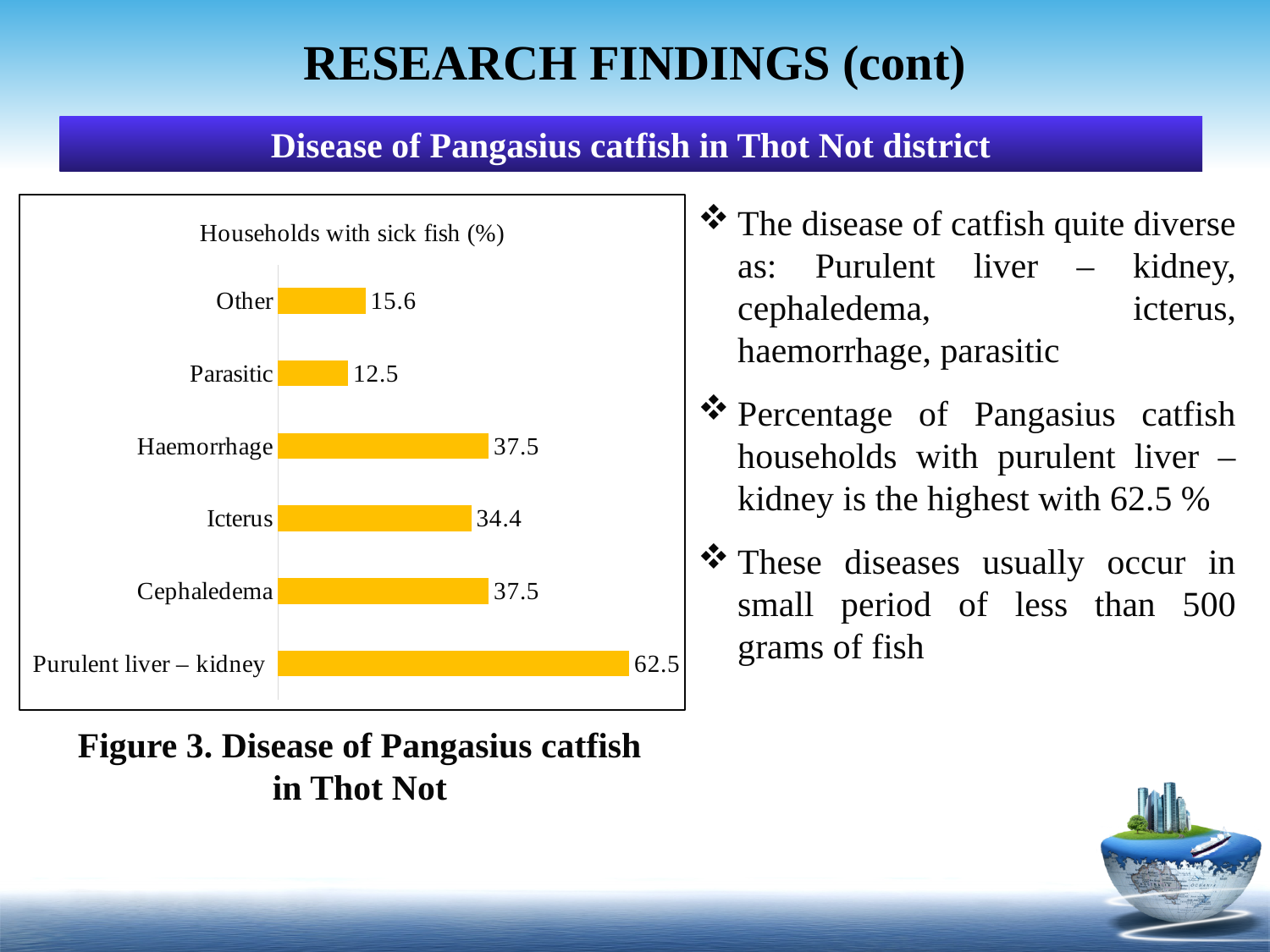
What is the difference between the values for Other and Parasitic? 3.1 What is the difference between the values for Purulent liver – kidney and Haemorrhage? 25 How many disease categories are shown in the chart? 6 What kind of chart is shown on the slide? Bar chart What is the value for Other in the chart? 15.6 Which disease category has the lowest percentage of households with sick fish? Parasitic What is the value for Purulent liver – kidney in the chart? 62.5 What is the value for Parasitic in the chart? 12.5 Which disease category has the highest percentage of households with sick fish? Purulent liver – kidney What is the title of the chart? Households with sick fish (%) What is the value for Icterus in the chart? 34.4 Which is larger, the value for Icterus or the value for Cephaledema? Cephaledema